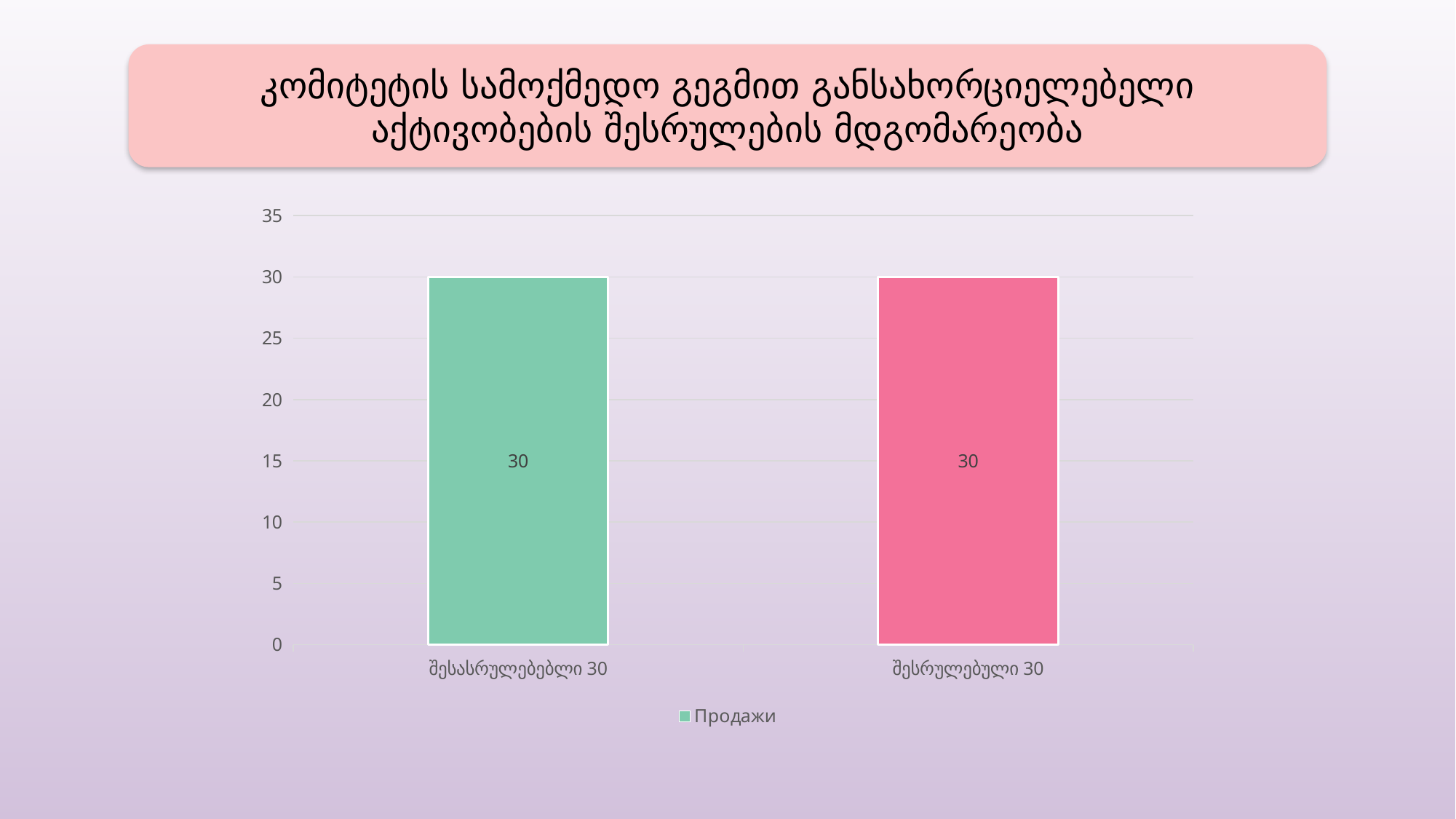
What is the difference between the values of the two bars? 0 What kind of chart is shown on the slide? bar chart How many series does the legend list? 1 Is the value for "შესასრულებებლი 30" greater or less than 35? less What is the total of the two bar values? 60 What colour is the bar for "შესრულებული 30"? pink What is the value of the bar labelled "შესასრულებებლი 30"? 30 How many bars are plotted in the chart? 2 What is the highest value shown on the vertical axis? 35 What is the value of the bar labelled "შესრულებული 30"? 30 Is the value for "შესრულებული 30" greater or less than 25? greater What is the name of the series shown in the legend? Продажи